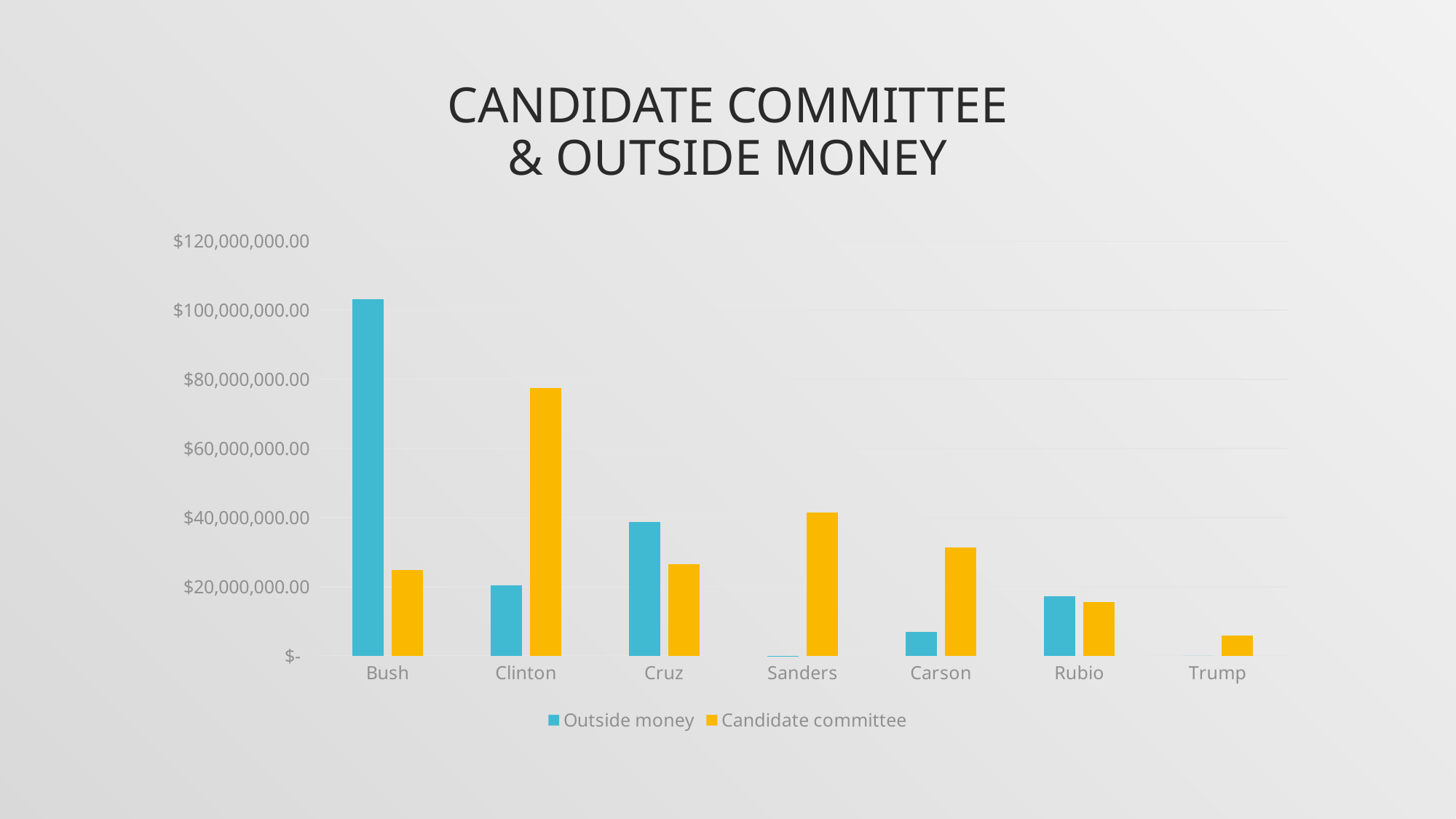
For Clinton, which is larger: Outside money or Candidate committee? Candidate committee Is the Outside money value for Rubio greater or less than $20,000,000.00? less How many series does the chart's legend list? 2 How many candidates are shown on the x axis of the chart? 7 What colour are the Candidate committee bars in the chart? Yellow Which candidate has the highest Outside money value? Bush What kind of chart is shown on the slide? Bar chart Which candidate has the highest Candidate committee value? Clinton Which candidate has the lowest Candidate committee value? Trump Is the Outside money value for Bush greater or less than $100,000,000.00? greater Is the Candidate committee value for Clinton greater or less than $80,000,000.00? less For Bush, which is larger: Outside money or Candidate committee? Outside money